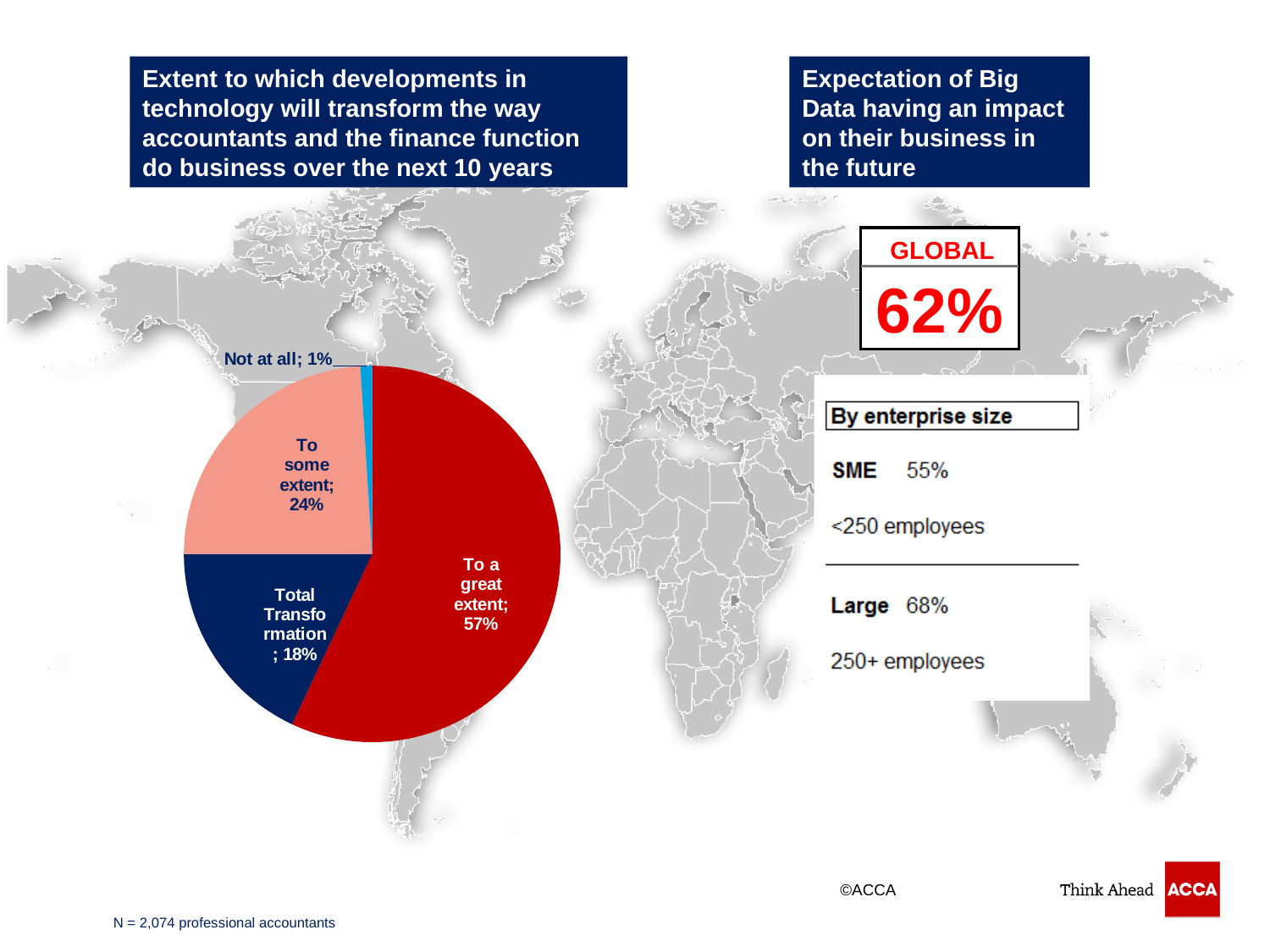
What is the difference in percentage points between 'To a great extent' and 'To some extent' in the pie chart? 33 In the pie chart, what percentage of respondents answered 'To some extent'? 24% What colour is the 'To a great extent' slice in the pie chart? red Which slice of the pie chart is the largest? To a great extent In the pie chart, what percentage of respondents answered 'Not at all'? 1% Which slice of the pie chart is the smallest? Not at all How many slices does the pie chart have? 4 What type of chart is shown on the left of the slide? pie chart In the pie chart, which is larger: 'To some extent' or 'Total Transformation'? To some extent In the pie chart, what percentage of respondents answered 'To a great extent'? 57% What is the difference in percentage points between 'To some extent' and 'Total Transformation' in the pie chart? 6 In the pie chart, what percentage of respondents answered 'Total Transformation'? 18%